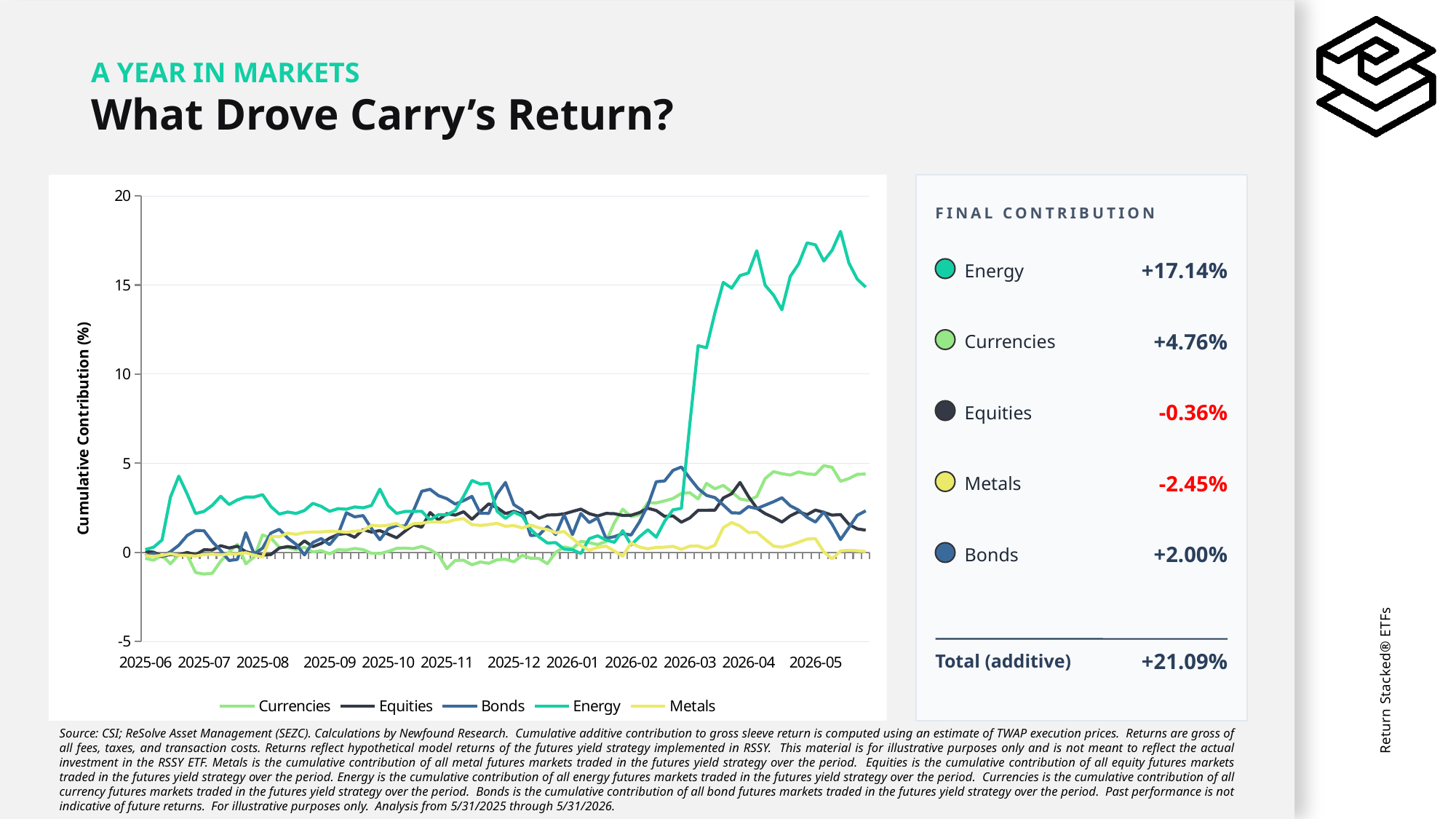
Which has a larger final contribution, Bonds or Currencies? Currencies What kind of chart is shown on the slide? Line chart What is the difference between the final contributions of Energy and Currencies? 12.38 percentage points How many series does the chart legend list? 5 According to the Final Contribution panel, what is the final contribution of Energy? +17.14% According to the Final Contribution panel, what is the final contribution of Metals? -2.45% Which series has the lowest final contribution? Metals According to the Final Contribution panel, what is the final contribution of Bonds? +2.00% Is the peak value of the Energy line greater or less than 15? greater Which series has the highest final contribution? Energy What is the total (additive) contribution shown on the slide? +21.09% What is the label of the y-axis? Cumulative Contribution (%)